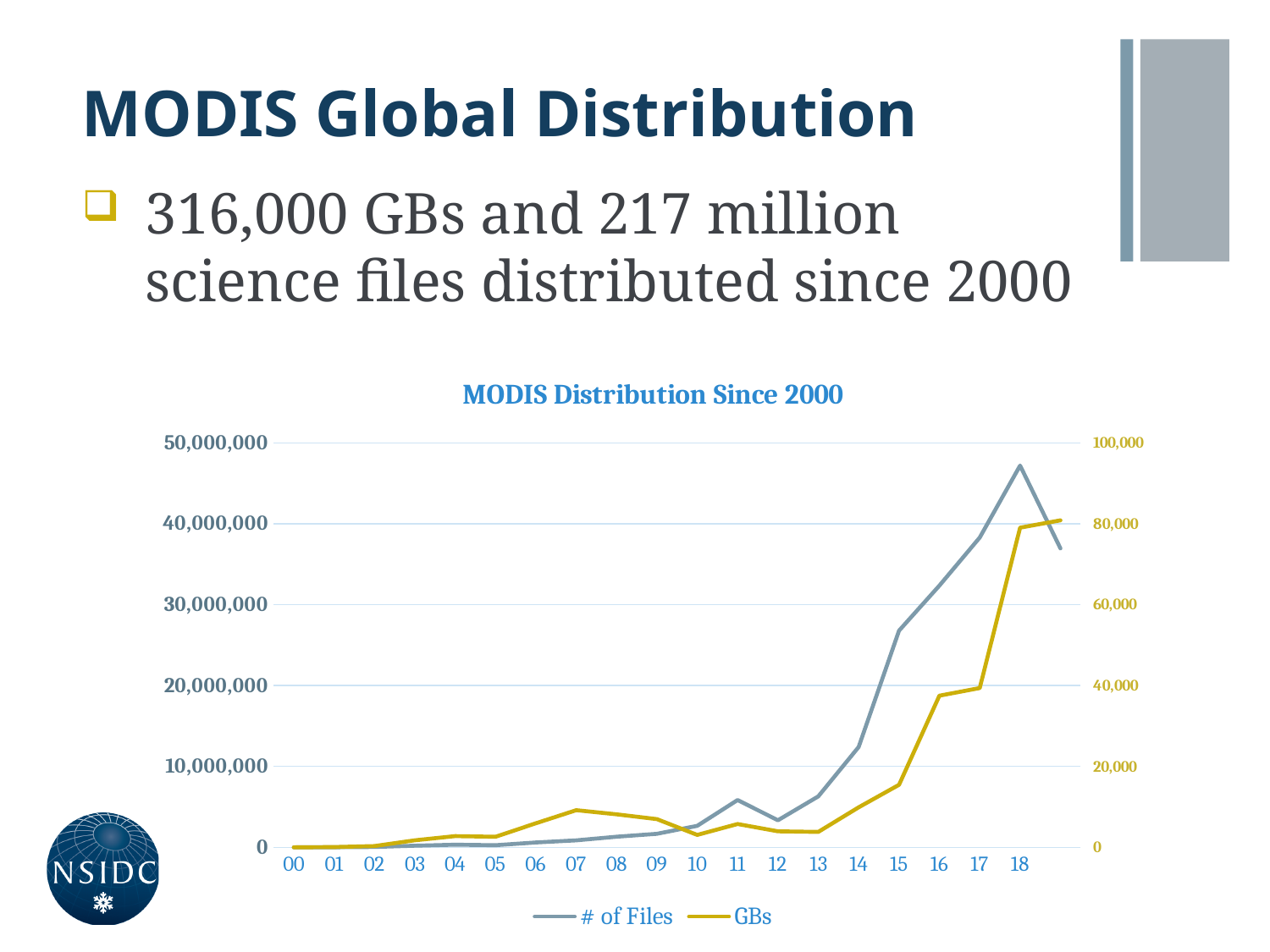
Is the # of Files value for 18 greater or less than 40,000,000? greater Which series is drawn in the gold/yellow line? GBs Which year has the larger # of Files value, 17 or 18? 18 Does the # of Files series rise or fall from 14 to 17? rise Is the GBs value for 18 greater or less than 60,000? greater What is the title of the chart? MODIS Distribution Since 2000 Is the GBs value for 15 greater or less than 20,000? less How many years are plotted along the x axis of the chart? 19 What kind of chart is shown on the slide? line chart How many series does the legend of the chart list? 2 In which year does the # of Files series reach its highest value? 18